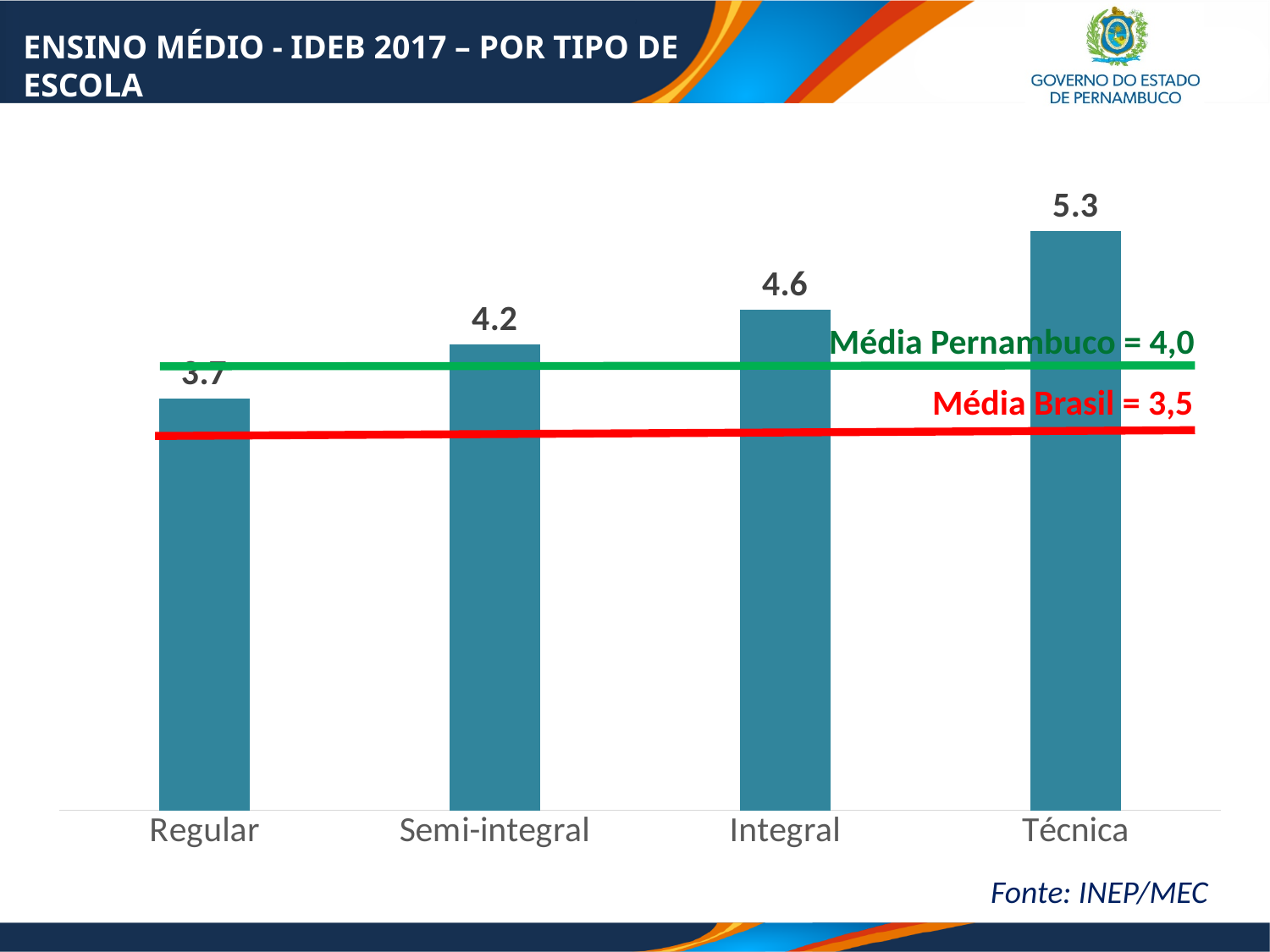
What is the IDEB 2017 value for Técnica schools? 5.3 What value does the green reference line labelled Média Pernambuco represent? 4,0 What is the IDEB 2017 value for Semi-integral schools? 4.2 Do the IDEB values rise or fall from Regular to Técnica along the x axis? Rise Which type of school has the highest IDEB 2017 value? Técnica Which type of school has the lowest IDEB 2017 value? Regular How many school types are shown in the chart? 4 What kind of chart is shown on the slide? Bar chart What is the difference between the IDEB values for Integral and Semi-integral schools? 0.4 Which has a higher IDEB value, Semi-integral or Integral schools? Integral What is the IDEB 2017 value for Integral schools? 4.6 What is the difference between the IDEB values for Técnica and Integral schools? 0.7